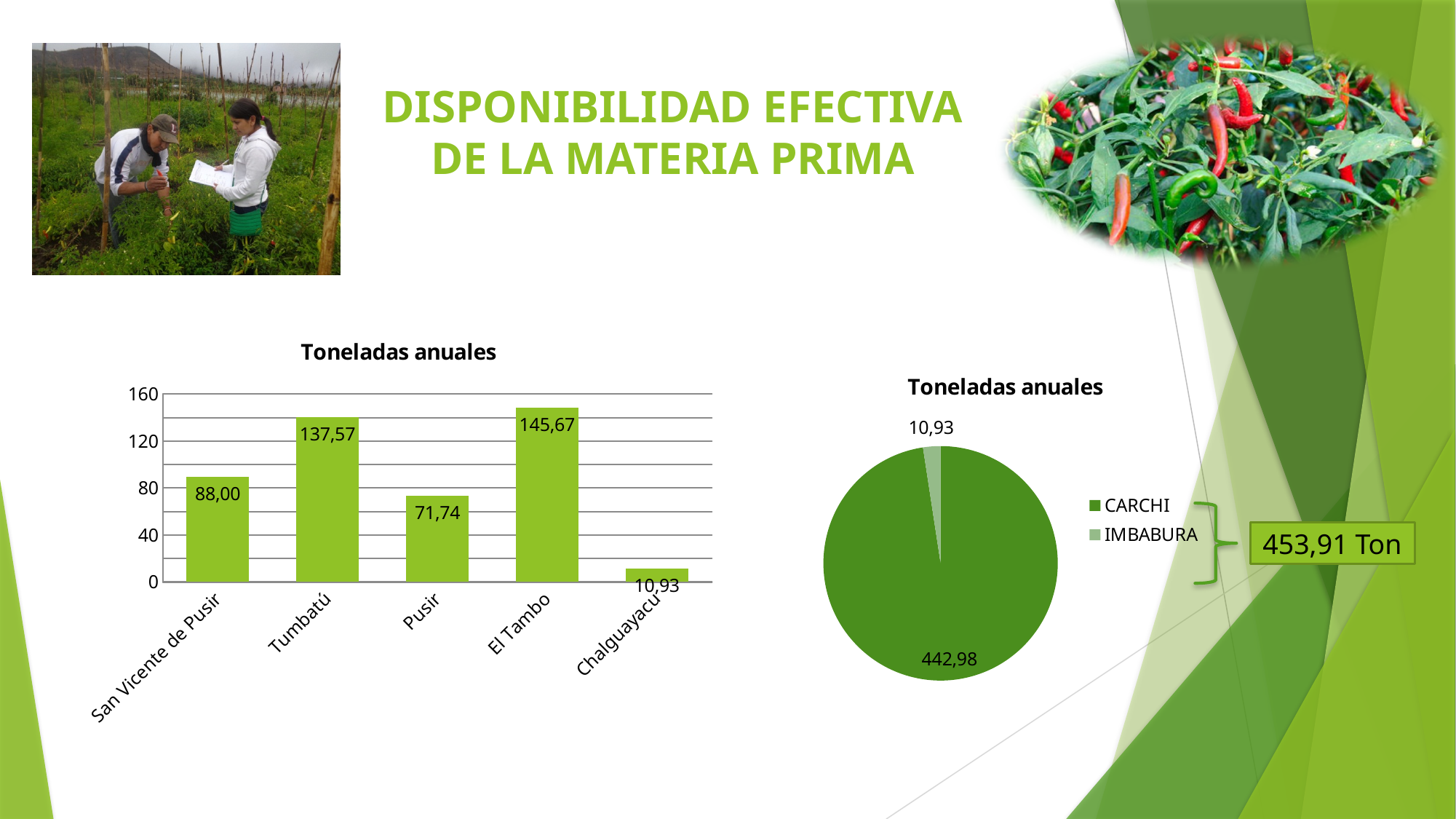
In the bar chart on the left, which category has the lowest value? Chalguayacu In the bar chart on the left, what is the value for San Vicente de Pusir? 88,00 In the bar chart on the left, what is the value for El Tambo? 145,67 How many categories are shown in the bar chart on the left? 5 In the bar chart on the left, is the value for Tumbatú greater or less than 120? greater What kind of chart is the chart on the left of the slide? bar chart In the pie chart on the right, what is the value for CARCHI? 442,98 How many entries does the legend of the pie chart on the right list? 2 In the bar chart on the left, which is larger, the value for San Vicente de Pusir or the value for Pusir? San Vicente de Pusir In the pie chart on the right, what is the value for IMBABURA? 10,93 In the bar chart on the left, which category has the highest value? El Tambo In the bar chart on the left, what is the difference between the values for El Tambo and Tumbatú? 8,10